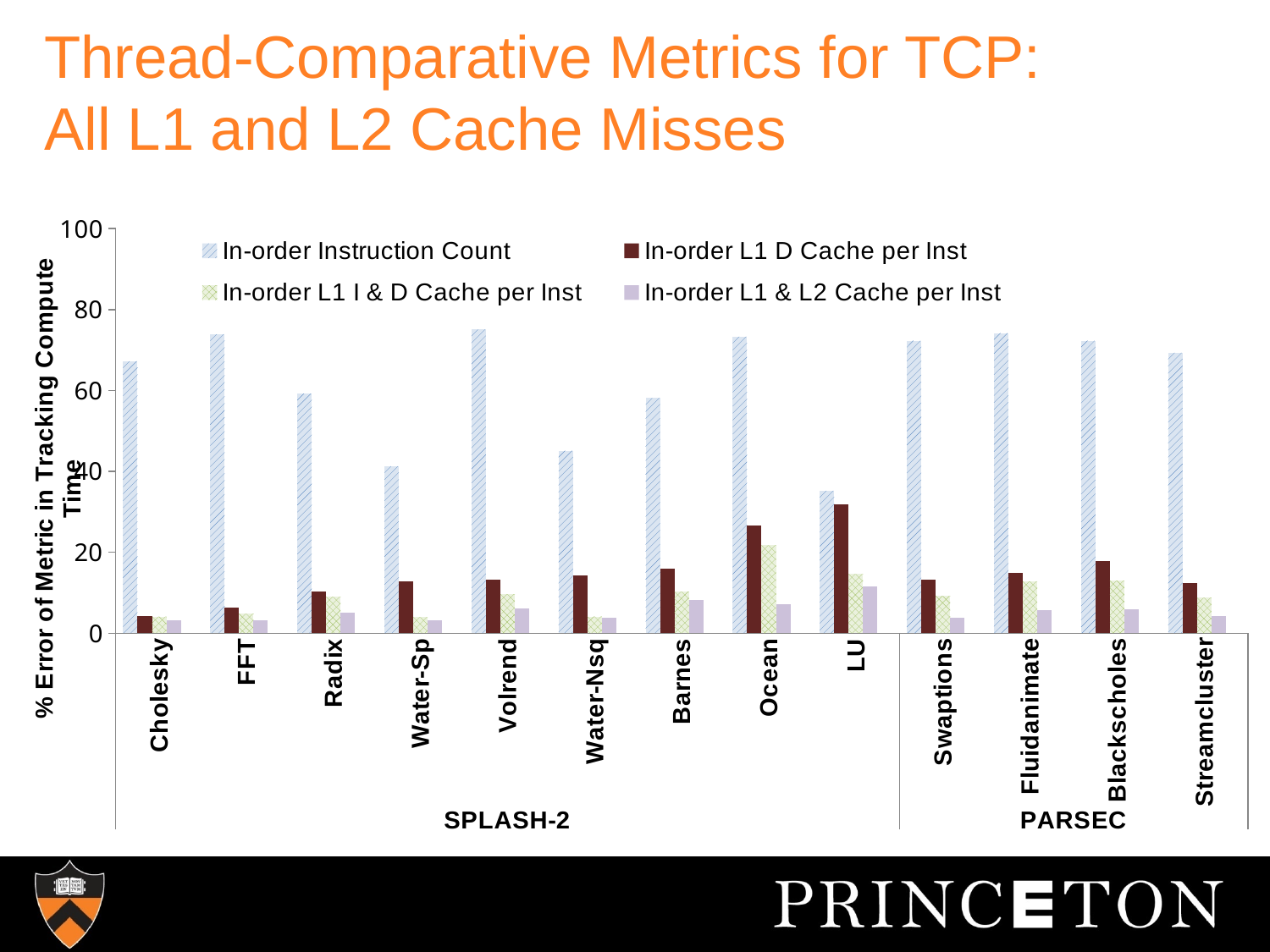
Is the In-order Instruction Count value for Volrend greater or less than 60? greater Which is larger for Barnes, the In-order Instruction Count value or the In-order L1 & L2 Cache per Inst value? In-order Instruction Count What kind of chart is shown on the slide? bar chart What are the two benchmark suite groups labelled below the x axis? SPLASH-2 and PARSEC Is the In-order Instruction Count value for LU greater or less than 40? less Is the In-order Instruction Count value for Cholesky greater or less than 60? greater How many series does the legend list? 4 Which benchmark has the lowest In-order Instruction Count value? LU How many benchmark categories are plotted along the x axis? 13 Which is larger, the In-order L1 D Cache per Inst value for Ocean or for Cholesky? Ocean Which benchmark has the highest In-order L1 D Cache per Inst value? LU